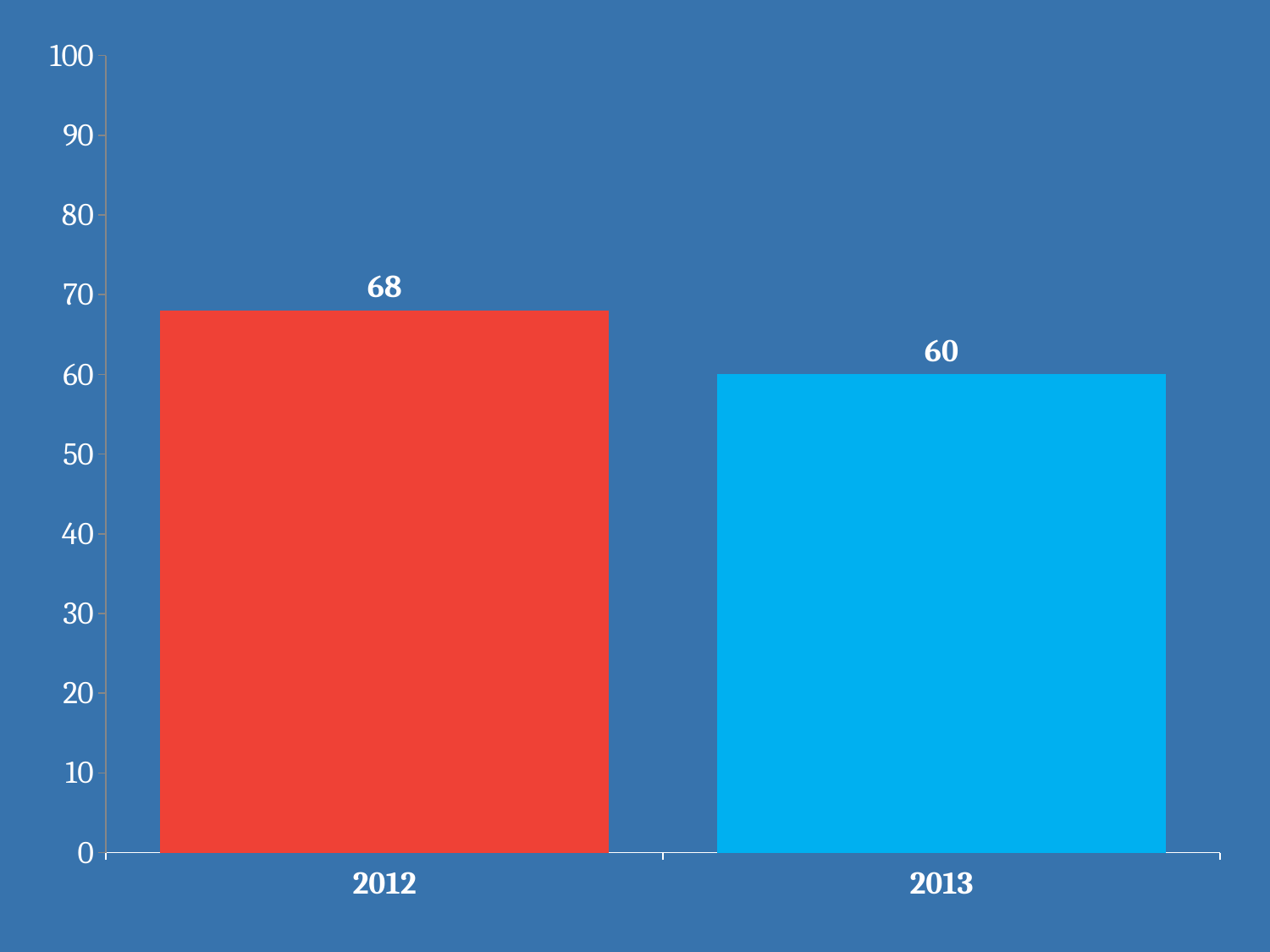
Do the values rise or fall from 2012 to 2013? fall Is the value for 2012 greater or less than 60? greater What is the difference between the values for 2012 and 2013? 8 How many categories are shown on the x axis? 2 What colour is the bar for 2013? light blue Which year has the lowest value? 2013 What is the value for 2013? 60 What kind of chart is shown on the slide? bar chart Is the value for 2013 greater or less than 70? less What is the value for 2012? 68 Which is larger, the value for 2012 or the value for 2013? 2012 Which year has the highest value? 2012